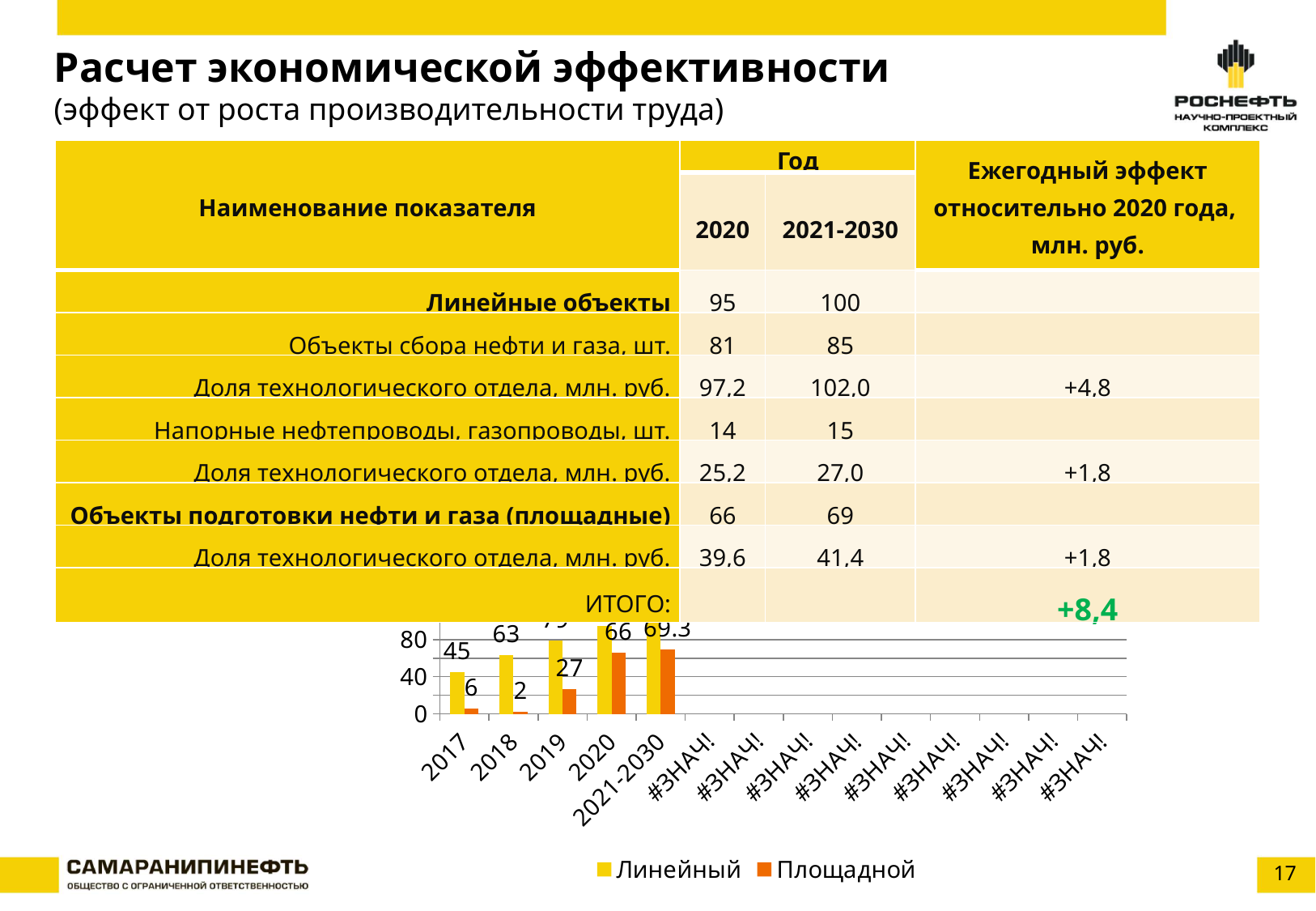
What is the value of Линейный for 2017 in the chart? 45 Is the Линейный value for 2019 in the chart greater or less than 40? greater What is the value of Площадной for 2018 in the chart? 2 What is the value of Площадной for 2017 in the chart? 6 What is the value of Линейный for 2018 in the chart? 63 In the chart, what is the difference between the Линейный and Площадной values for 2018? 61 How many category labels on the chart's x axis read #ЗНАЧ!? 9 What are the two series named in the chart legend? Линейный and Площадной How many series does the chart legend list? 2 What kind of chart is shown at the bottom of the slide? bar chart What is the value of Площадной for 2019 in the chart? 27 In the chart, which series has the larger value for 2017, Линейный or Площадной? Линейный